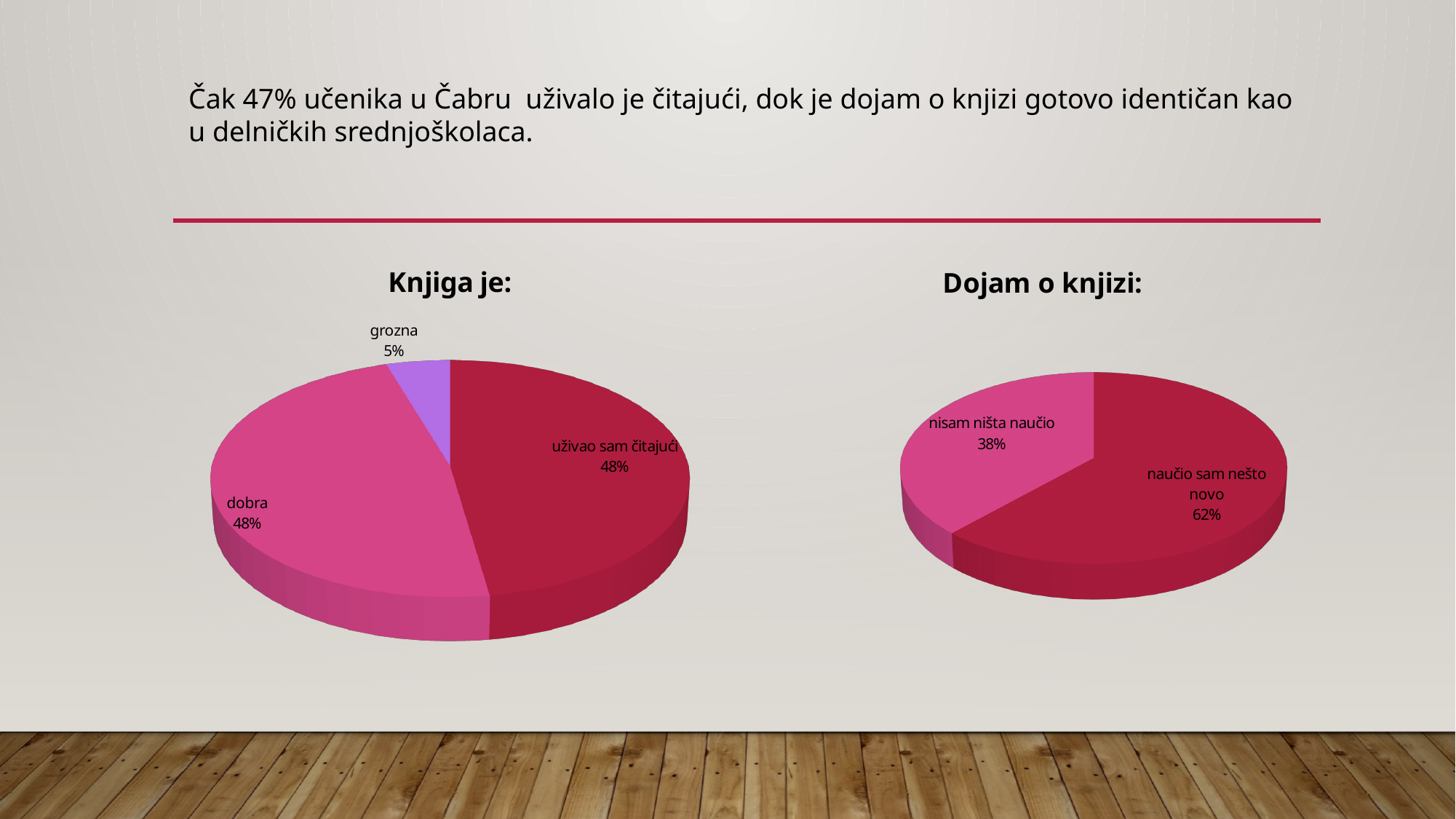
In the chart titled "Knjiga je:", which category has the smallest slice? grozna In the chart titled "Dojam o knjizi:", which category has the largest slice? naučio sam nešto novo In the chart titled "Knjiga je:", what share of the pie is labelled "grozna"? 5% In the chart titled "Knjiga je:", what is the difference in percentage points between "dobra" and "grozna"? 43 In the chart titled "Dojam o knjizi:", what percentage is shown for "naučio sam nešto novo"? 62% What type of chart is the chart titled "Dojam o knjizi:"? pie chart In the chart titled "Dojam o knjizi:", what is the difference in percentage points between "naučio sam nešto novo" and "nisam ništa naučio"? 24 In the chart titled "Dojam o knjizi:", which is larger: "naučio sam nešto novo" or "nisam ništa naučio"? naučio sam nešto novo In the chart titled "Knjiga je:", what percentage is shown for "dobra"? 48% In the chart titled "Dojam o knjizi:", what share of the pie is labelled "nisam ništa naučio"? 38% In the chart titled "Knjiga je:", how many slices does the pie have? 3 In the chart titled "Knjiga je:", what percentage is shown for "uživao sam čitajući"? 48%